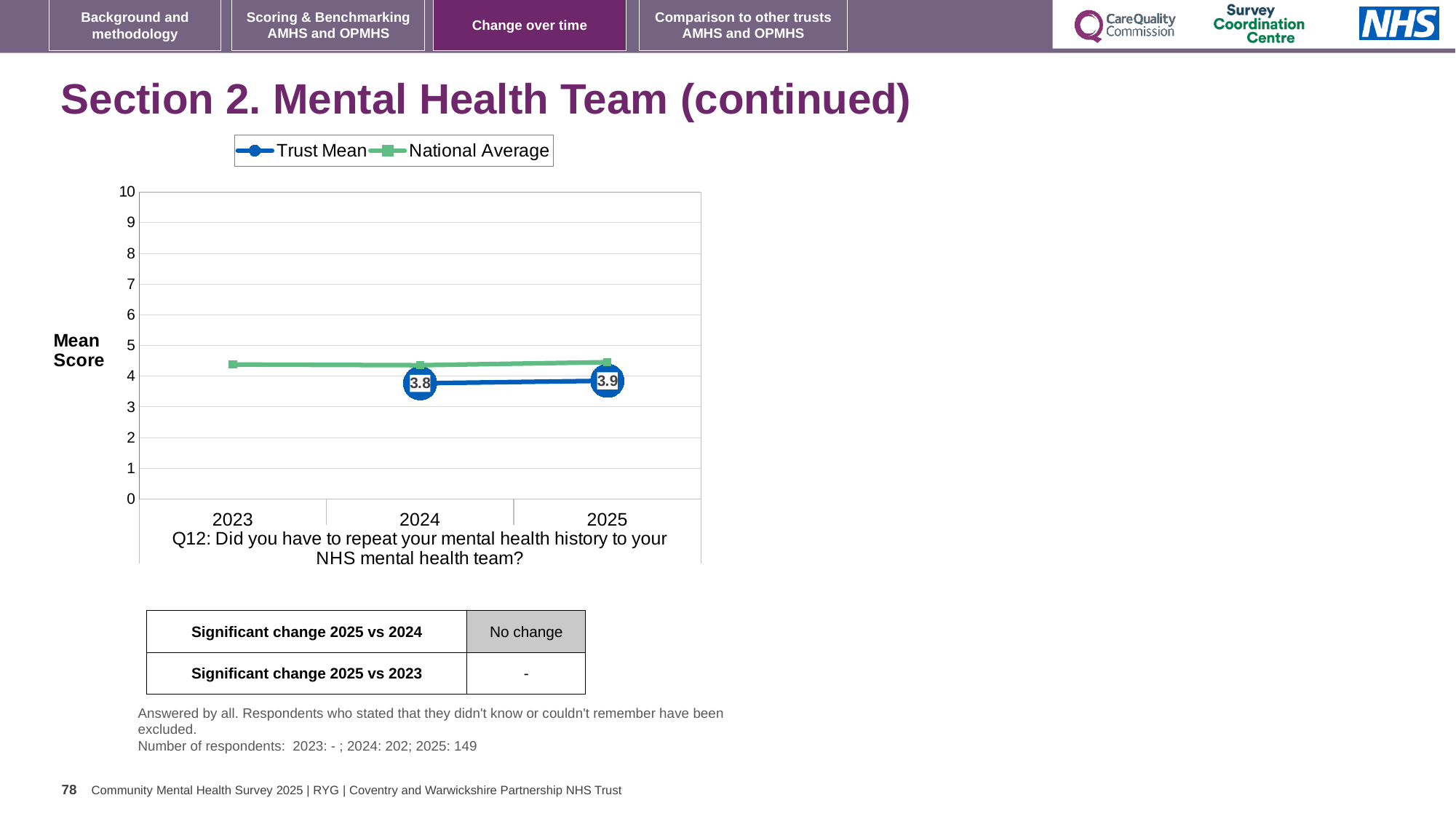
What is the Trust Mean score for 2024? 3.8 Is the National Average value for 2025 greater or less than 4? greater By how much did the Trust Mean change from 2024 to 2025? 0.1 How many series does the legend list? 2 What is the Trust Mean score for 2025? 3.9 Which year has the higher Trust Mean, 2024 or 2025? 2025 What is the label on the y axis of the chart? Mean Score Is the National Average value for 2023 greater or less than 5? less What kind of chart is shown on the slide? Line chart Does the Trust Mean rise or fall from 2024 to 2025? Rise In 2024, which series is higher, Trust Mean or National Average? National Average How many years are shown on the x axis? 3